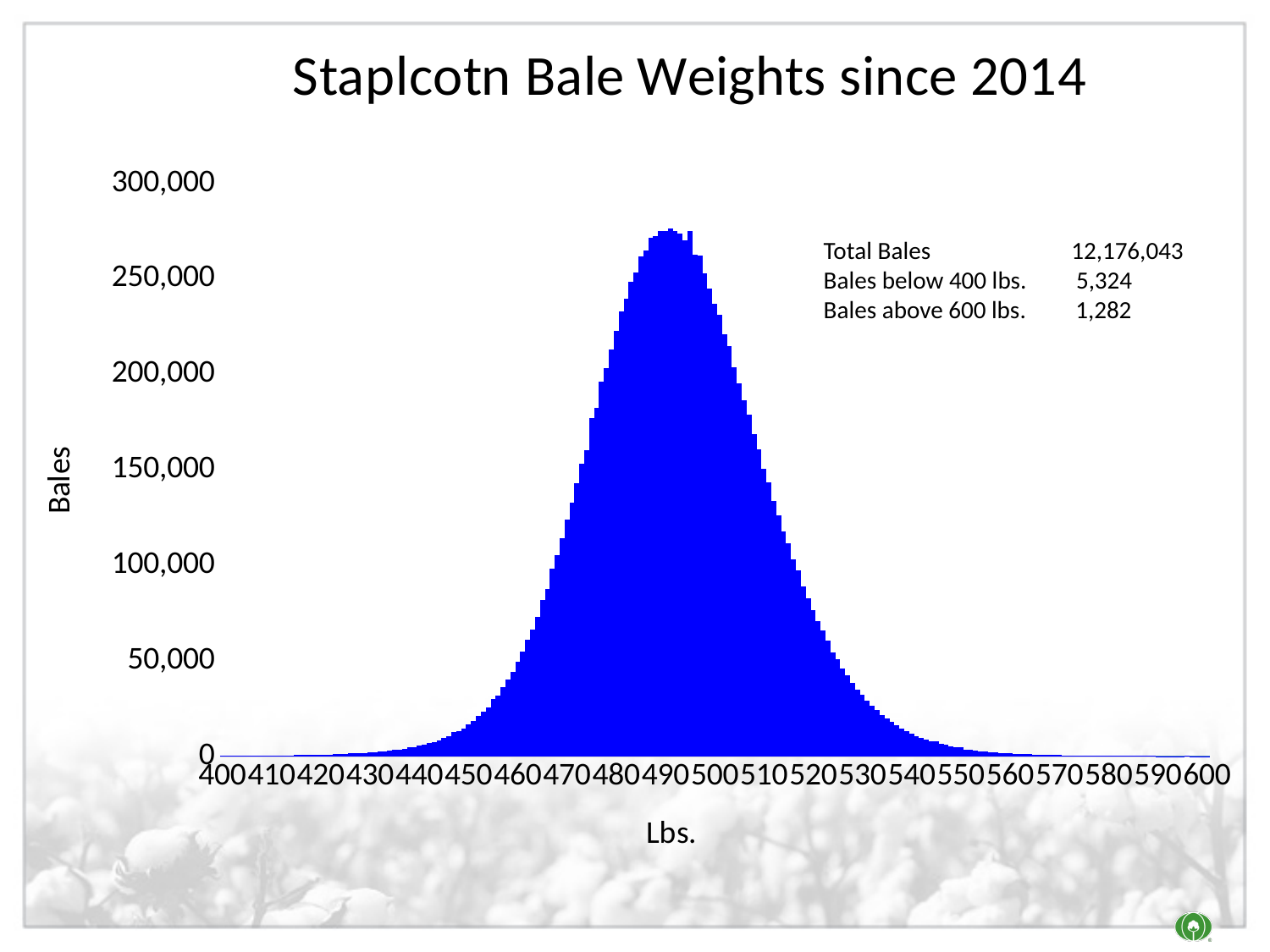
Is the number of bales at 510 lbs greater or less than 100,000? greater Is the number of bales at 450 lbs greater or less than 50,000? less Is the number of bales at 490 lbs greater or less than 250,000? greater What is the title of the chart? Staplcotn Bale Weights since 2014 Which weight has more bales, 450 lbs or 500 lbs? 500 lbs Do the bale counts rise or fall as weight increases from 400 lbs to 490 lbs? rise What kind of chart is shown on the slide? bar chart Which weight has more bales, 480 lbs or 520 lbs? 480 lbs What is the total number of bales stated on the slide? 12,176,043